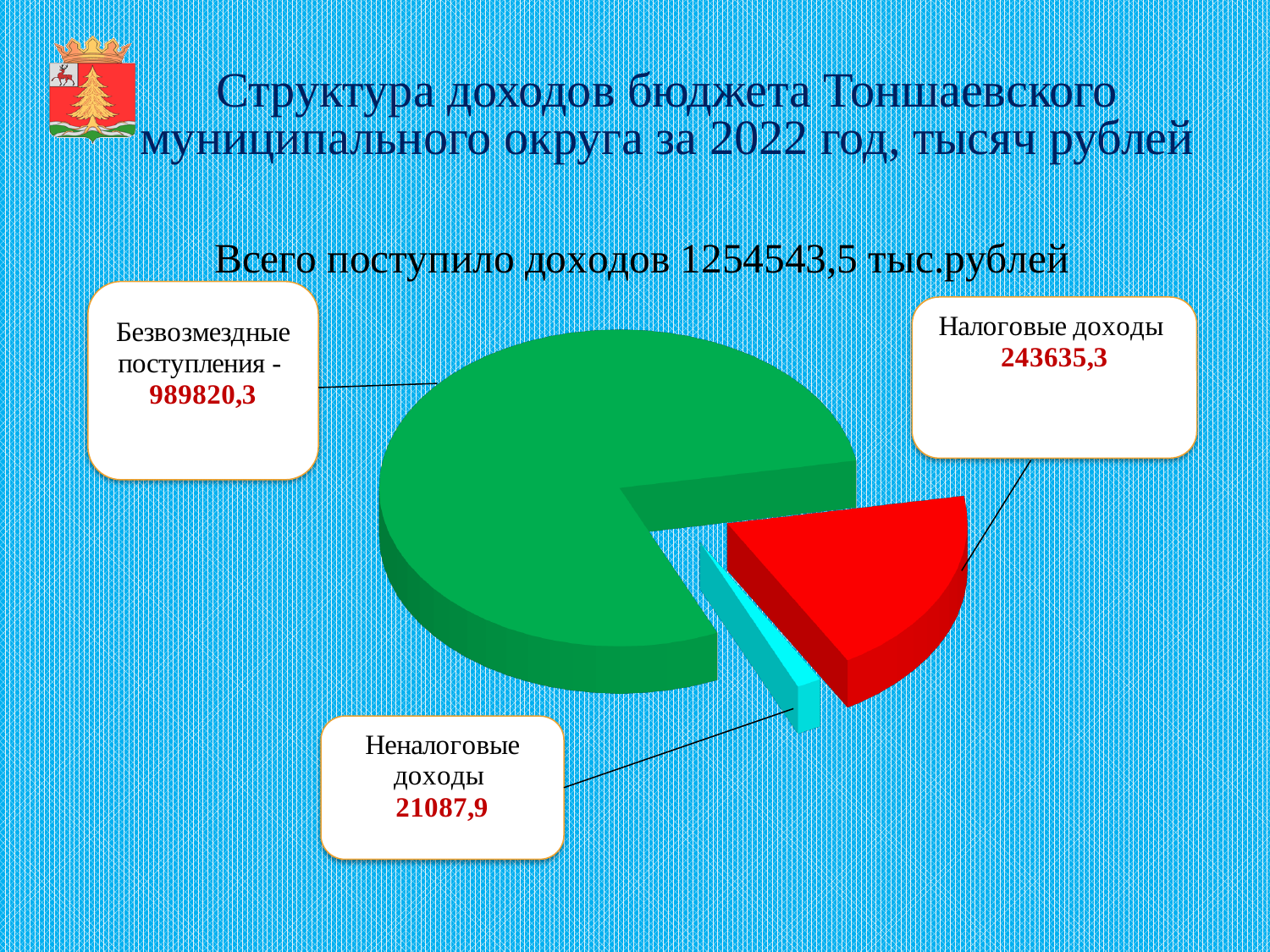
What is the total of all revenues shown on the slide? 1254543,5 тыс.рублей What is the value for Безвозмездные поступления? 989820,3 What is the value for Налоговые доходы? 243635,3 How many slices does the pie chart have? 3 What is the value for Неналоговые доходы? 21087,9 What colour is the slice for Налоговые доходы? Red What is the difference between Налоговые доходы and Неналоговые доходы? 222547,4 What is the difference between Безвозмездные поступления and Налоговые доходы? 746185,0 Which category has the smallest slice of the pie? Неналоговые доходы Which is larger, Налоговые доходы or Неналоговые доходы? Налоговые доходы Which category has the largest slice of the pie? Безвозмездные поступления What type of chart is shown on the slide? Pie chart